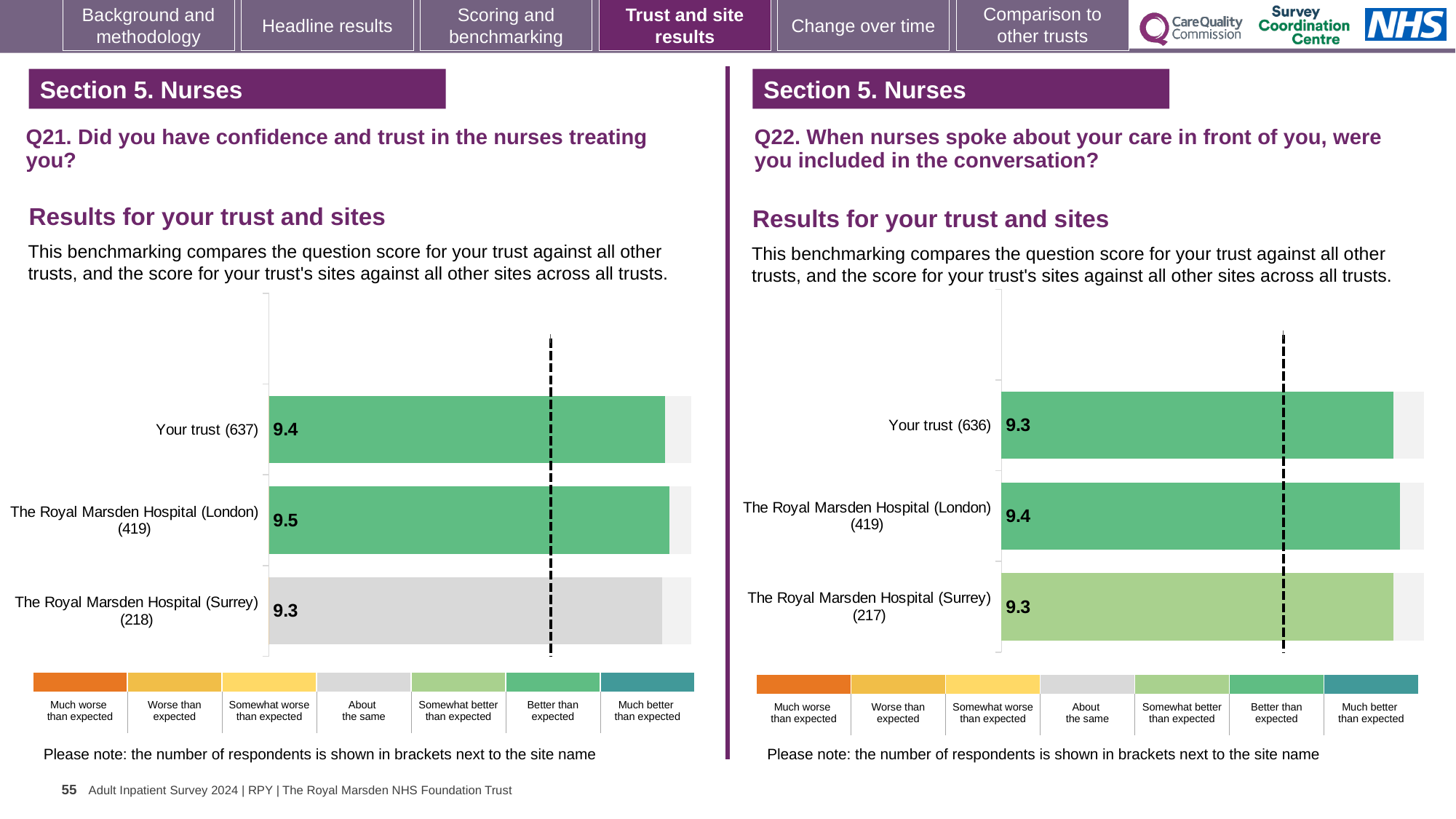
In the Q22 chart on the right, what is the score for The Royal Marsden Hospital (London)? 9.4 In the Q22 chart on the right, what is the score for Your trust? 9.3 In the Q22 chart on the right, what is the difference between the scores for The Royal Marsden Hospital (London) and Your trust? 0.1 In the Q21 chart on the left, which site or trust has the highest score? The Royal Marsden Hospital (London) In the Q21 chart on the left, which benchmark category does the grey colour of The Royal Marsden Hospital (Surrey) bar represent according to the legend? About the same In the Q21 chart on the left, which site or trust has the lowest score? The Royal Marsden Hospital (Surrey) What kind of chart is used for the Q22 results on the right? Bar chart In the Q21 chart on the left, what is the score for The Royal Marsden Hospital (Surrey)? 9.3 In the Q22 chart on the right, which site or trust has the highest score? The Royal Marsden Hospital (London) In the Q21 chart on the left, what is the score for Your trust? 9.4 In the Q21 chart on the left, how many bars are plotted? 3 In the Q21 chart on the left, what is the difference between the scores for The Royal Marsden Hospital (London) and The Royal Marsden Hospital (Surrey)? 0.2